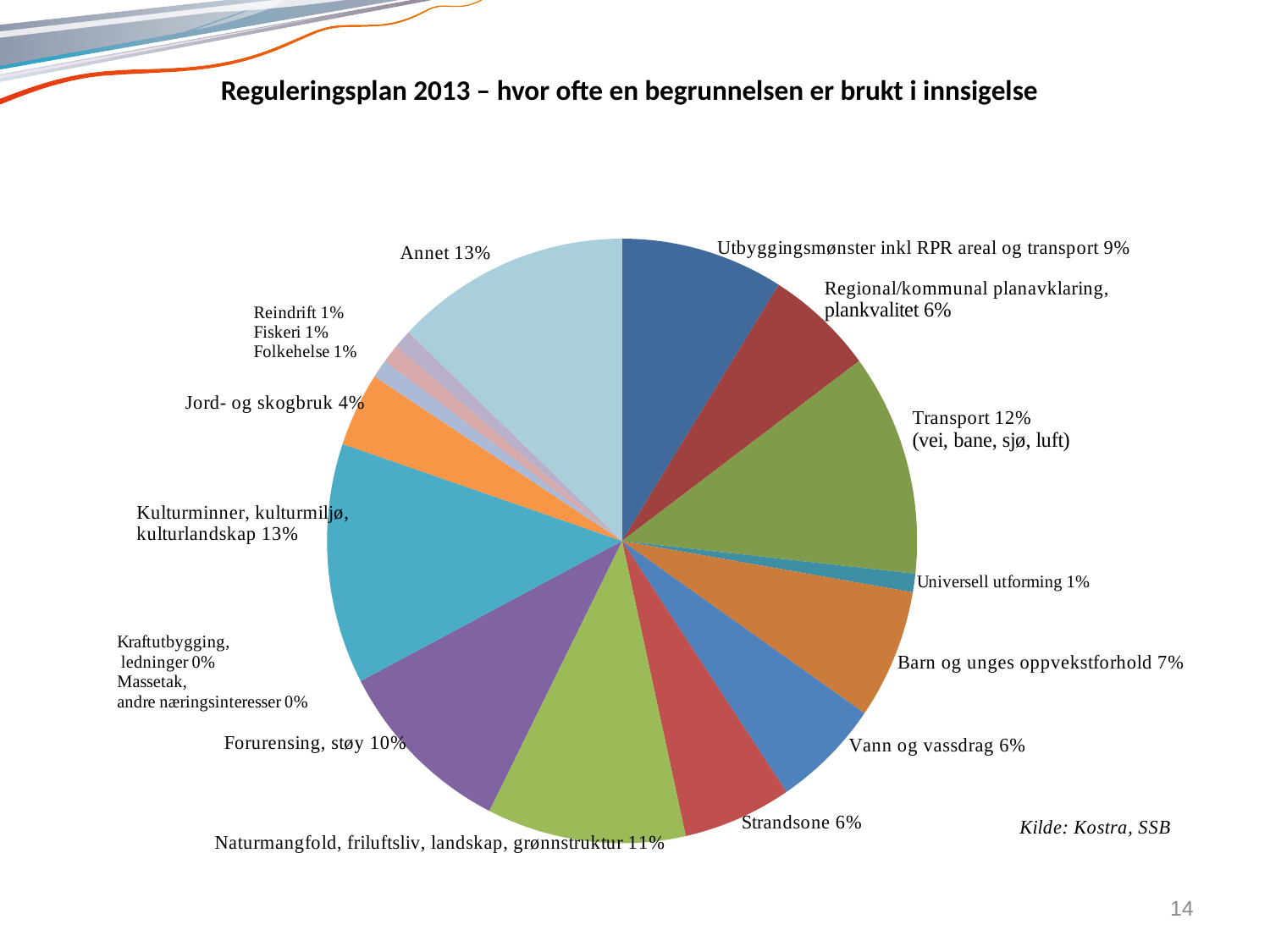
What percentage is shown for Naturmangfold, friluftsliv, landskap, grønnstruktur? 11% What share of the pie does Transport (vei, bane, sjø, luft) represent? 12% Which is larger, the share for Kulturminner, kulturmiljø, kulturlandskap or the share for Strandsone? Kulturminner, kulturmiljø, kulturlandskap What percentage is shown for Jord- og skogbruk? 4% Which is larger, the share for Transport (vei, bane, sjø, luft) or the share for Forurensing, støy? Transport (vei, bane, sjø, luft) What percentage is shown for Forurensing, støy? 10% What source is cited for the chart data? Kilde: Kostra, SSB What type of chart is shown on the slide? pie chart What is the difference in percentage points between Annet and Utbyggingsmønster inkl RPR areal og transport? 4 What is the title of the chart on the slide? Reguleringsplan 2013 – hvor ofte en begrunnelsen er brukt i innsigelse How many categories are labelled in the pie chart? 17 What percentage is shown for Barn og unges oppvekstforhold? 7%